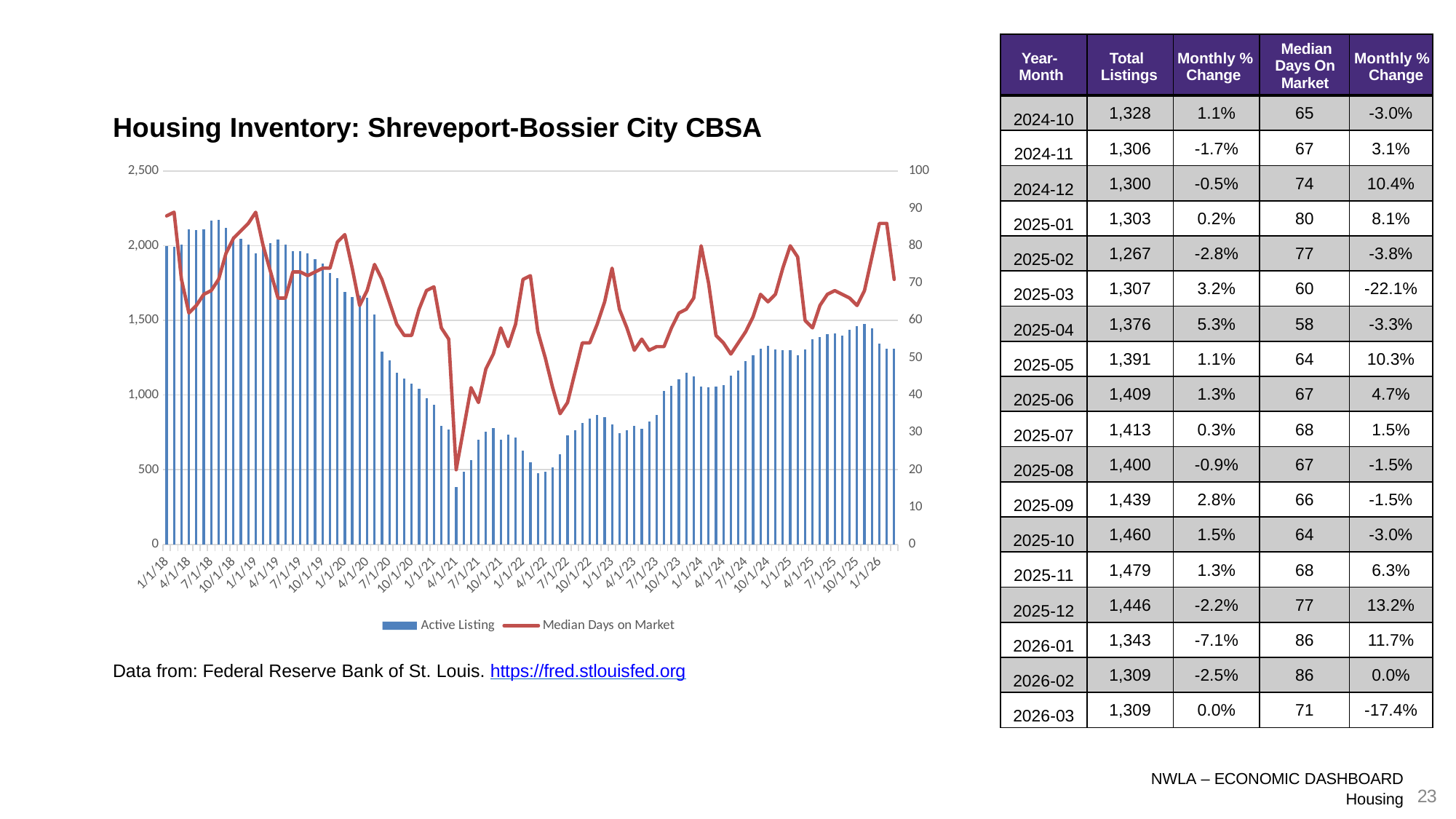
Is the Median Days on Market value at 1/1/26 greater or less than 80? greater Do the Active Listing bars rise or fall from 1/1/18 to 4/1/21? fall How many series does the chart legend list? 2 Is the Active Listing value at 7/1/18 greater or less than 2,000? greater Do the Active Listing bars rise or fall from 4/1/21 to 10/1/25? rise Is the Median Days on Market value at 4/1/21 greater or less than 40? less Around which x-axis date does the Median Days on Market line reach its lowest point? 4/1/21 What is the highest value shown on the chart's right-hand axis? 100 What are the two series named in the chart legend? Active Listing and Median Days on Market What kind of chart is shown on the slide? A combination bar and line chart What is the title of the chart? Housing Inventory: Shreveport-Bossier City CBSA